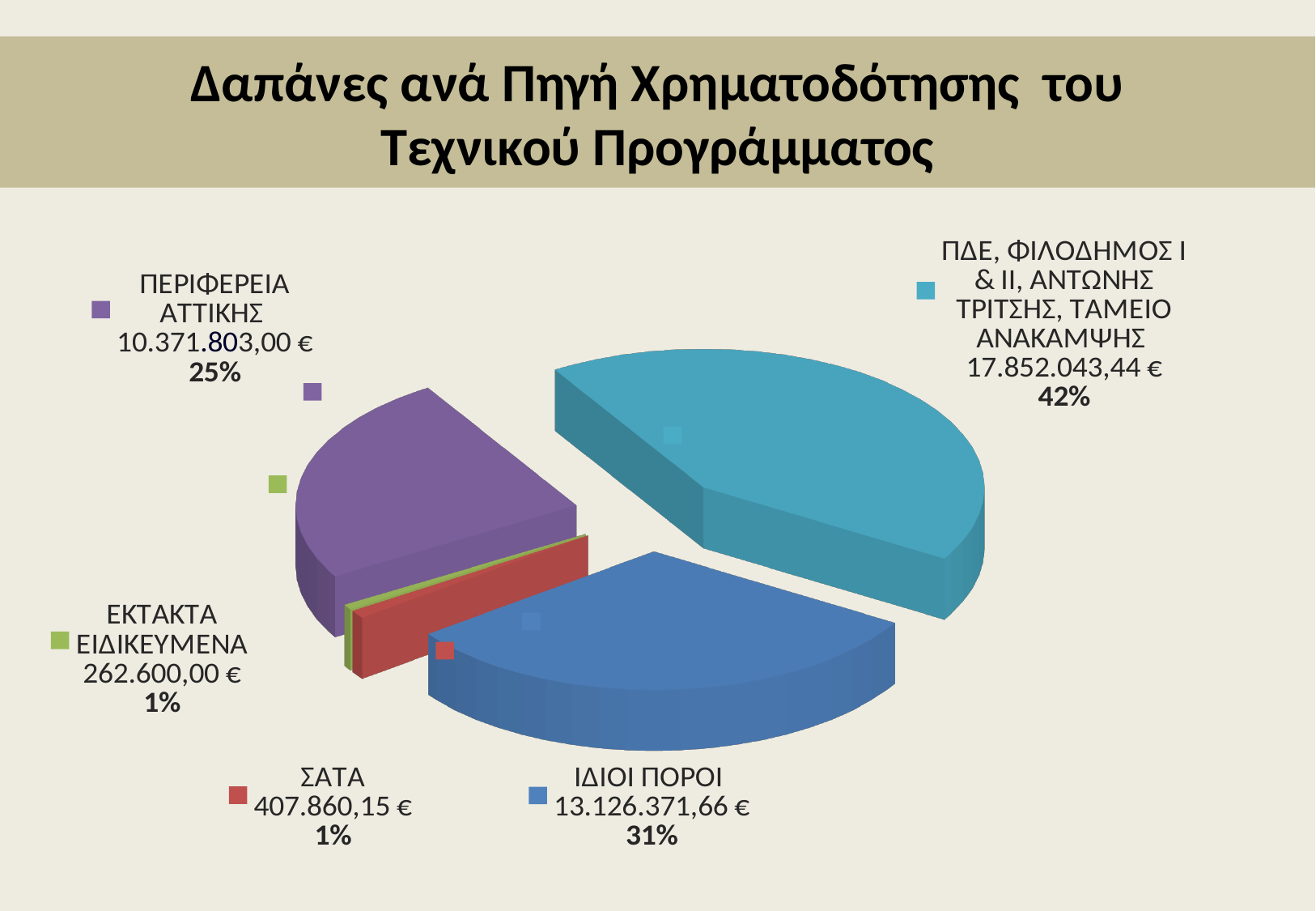
How many slices does the pie chart have? 5 Which funding source has the smallest value? ΕΚΤΑΚΤΑ ΕΙΔΙΚΕΥΜΕΝΑ Which funding source has the largest slice? ΠΔΕ, ΦΙΛΟΔΗΜΟΣ Ι & ΙΙ, ΑΝΤΩΝΗΣ ΤΡΙΤΣΗΣ, ΤΑΜΕΙΟ ΑΝΑΚΑΜΨΗΣ Which is larger, the value for ΣΑΤΑ or the value for ΕΚΤΑΚΤΑ ΕΙΔΙΚΕΥΜΕΝΑ? ΣΑΤΑ What is the value for ΣΑΤΑ? 407.860,15 € What is the value for ΙΔΙΟΙ ΠΟΡΟΙ? 13.126.371,66 € What share of the pie does ΠΔΕ, ΦΙΛΟΔΗΜΟΣ Ι & ΙΙ, ΑΝΤΩΝΗΣ ΤΡΙΤΣΗΣ, ΤΑΜΕΙΟ ΑΝΑΚΑΜΨΗΣ represent? 42% What is the title of the chart? Δαπάνες ανά Πηγή Χρηματοδότησης του Τεχνικού Προγράμματος What is the difference between the value for ΠΔΕ, ΦΙΛΟΔΗΜΟΣ Ι & ΙΙ, ΑΝΤΩΝΗΣ ΤΡΙΤΣΗΣ, ΤΑΜΕΙΟ ΑΝΑΚΑΜΨΗΣ and the value for ΙΔΙΟΙ ΠΟΡΟΙ? 4.725.671,78 € What is the value for ΠΕΡΙΦΕΡΕΙΑ ΑΤΤΙΚΗΣ? 10.371.803,00 € What share of the pie does ΕΚΤΑΚΤΑ ΕΙΔΙΚΕΥΜΕΝΑ represent? 1% What kind of chart is shown on the slide? pie chart